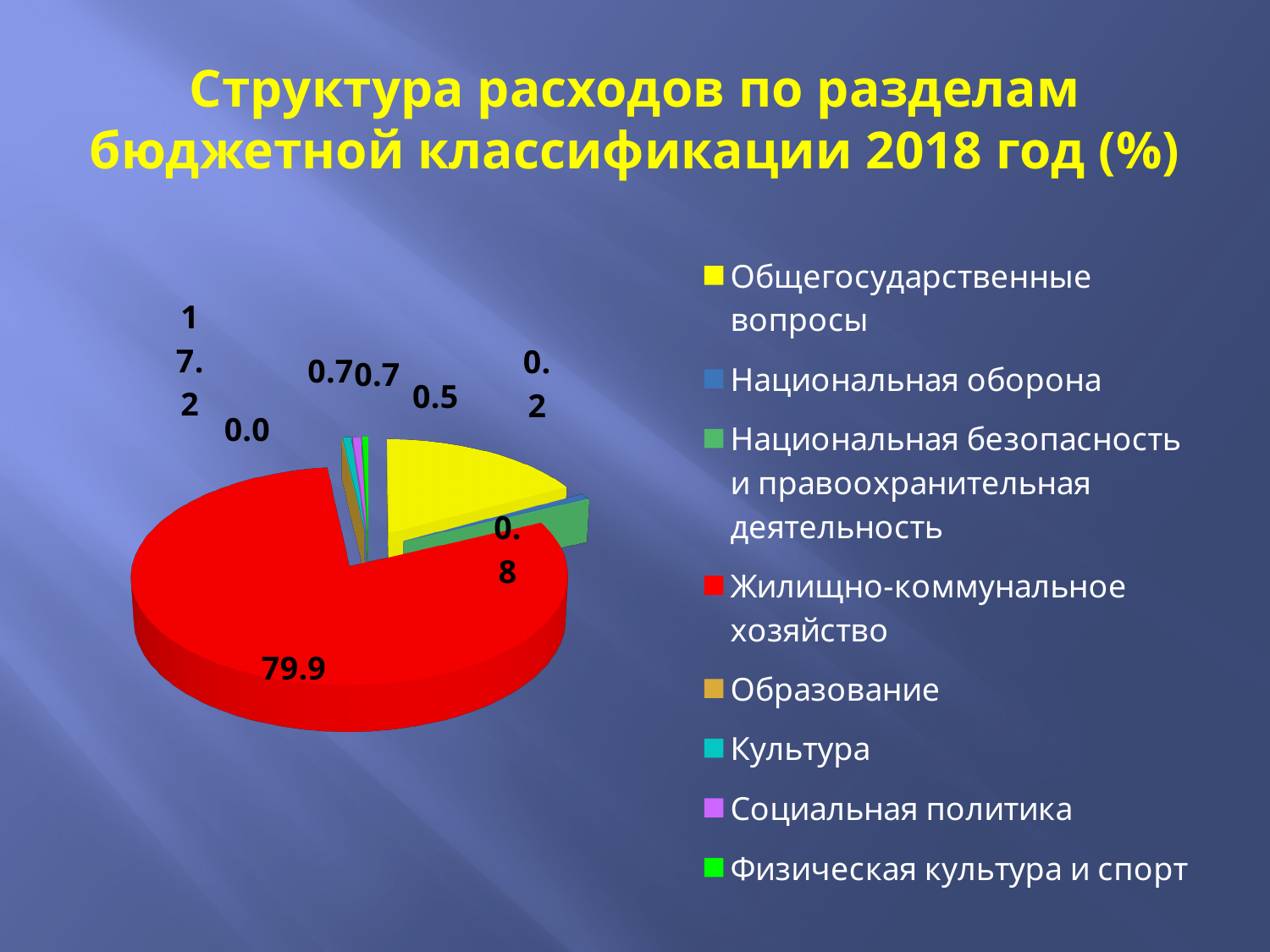
Which category has the largest slice of the pie? Жилищно-коммунальное хозяйство What is the difference between the values for Жилищно-коммунальное хозяйство and Общегосударственные вопросы? 62.7 What share of the pie does Жилищно-коммунальное хозяйство take? 79.9% How many categories does the legend list? 8 What is the value shown for Жилищно-коммунальное хозяйство? 79.9 Which is larger: Общегосударственные вопросы or Национальная безопасность и правоохранительная деятельность? Общегосударственные вопросы What is the value shown for Общегосударственные вопросы? 17.2 Which is larger: Жилищно-коммунальное хозяйство or Общегосударственные вопросы? Жилищно-коммунальное хозяйство What kind of chart is shown on the slide? pie chart What is the title of the chart? Структура расходов по разделам бюджетной классификации 2018 год (%) What colour is the slice for Жилищно-коммунальное хозяйство? red What is the value shown for Национальная безопасность и правоохранительная деятельность? 0.2